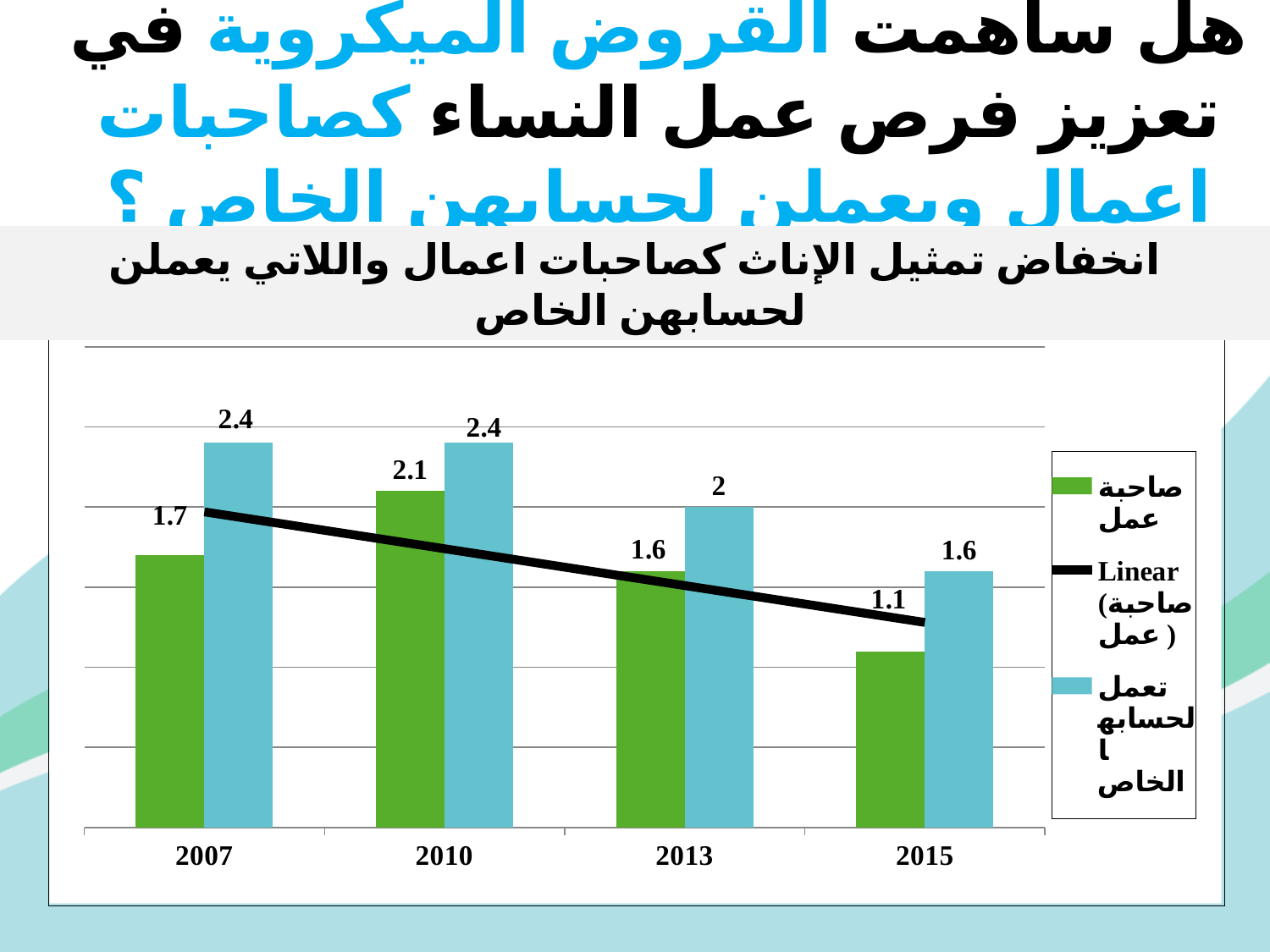
How many years are shown on the x axis? 4 What is the value for صاحبة عمل in 2007? 1.7 What type of chart is shown on the slide? bar chart Which is larger in 2010: the value for صاحبة عمل or the value for تعمل لحسابها الخاص? تعمل لحسابها الخاص In which year is the value for صاحبة عمل highest? 2010 What is the value for تعمل لحسابها الخاص in 2013? 2 What is the value for صاحبة عمل in 2015? 1.1 Do the values for تعمل لحسابها الخاص rise or fall from 2010 to 2015? fall In which year is the value for تعمل لحسابها الخاص lowest? 2015 What is the value for تعمل لحسابها الخاص in 2010? 2.4 What is the difference between the تعمل لحسابها الخاص value and the صاحبة عمل value in 2015? 0.5 How many entries does the legend list? 3